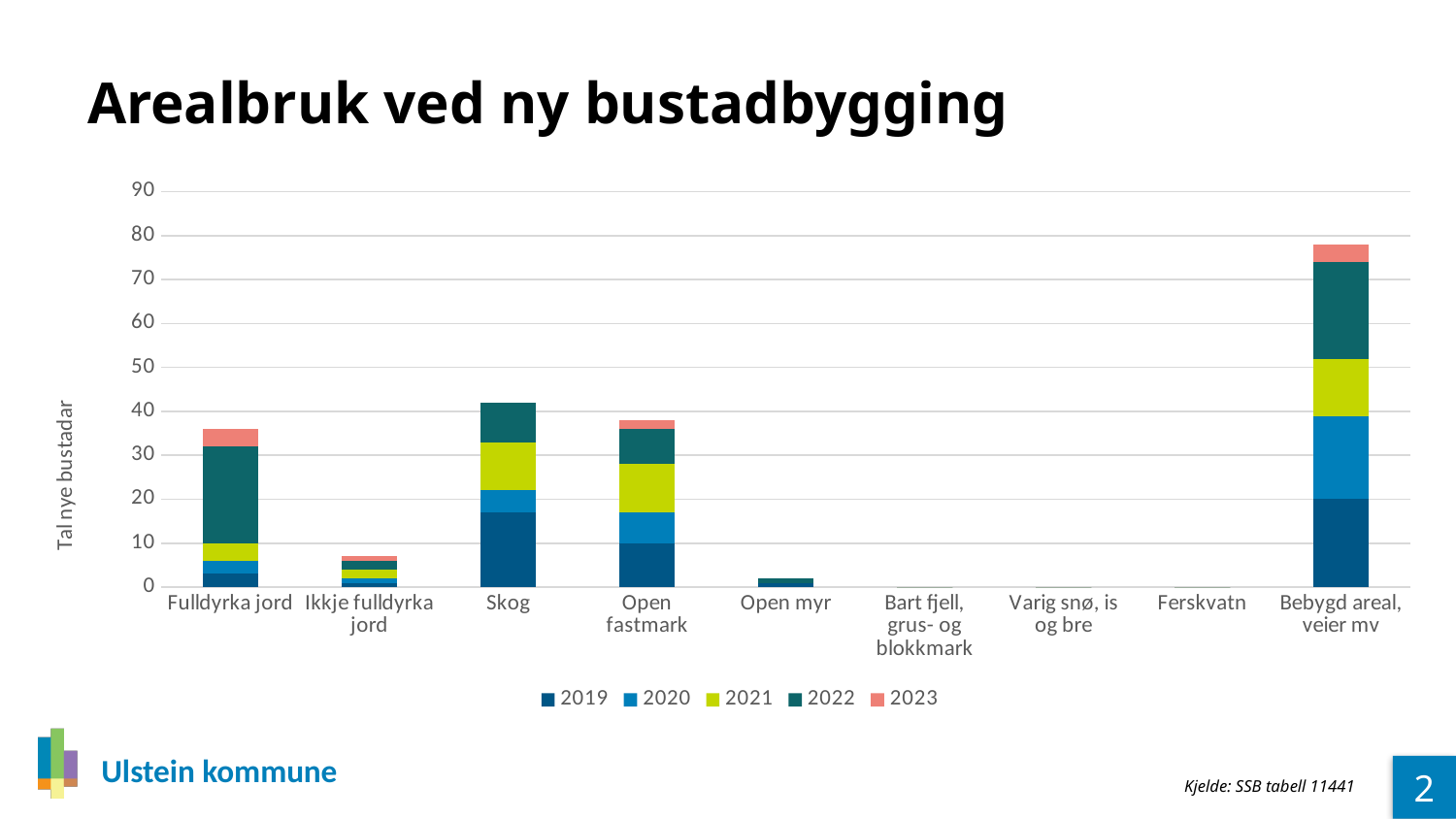
Is the total for Bebygd areal, veier mv greater or less than 70? greater How many categories are shown on the x axis? 9 Is the total for Open myr greater or less than 10? less Which category has the highest total stacked bar? Bebygd areal, veier mv How many series does the legend list? 5 What kind of chart is shown on the slide? Stacked bar chart Is the total for Skog greater or less than 30? greater What is the title of the chart? Arealbruk ved ny bustadbygging Which has the larger total, Ikkje fulldyrka jord or Open myr? Ikkje fulldyrka jord What is the label on the y axis? Tal nye bustadar Which has the larger total, Skog or Fulldyrka jord? Skog